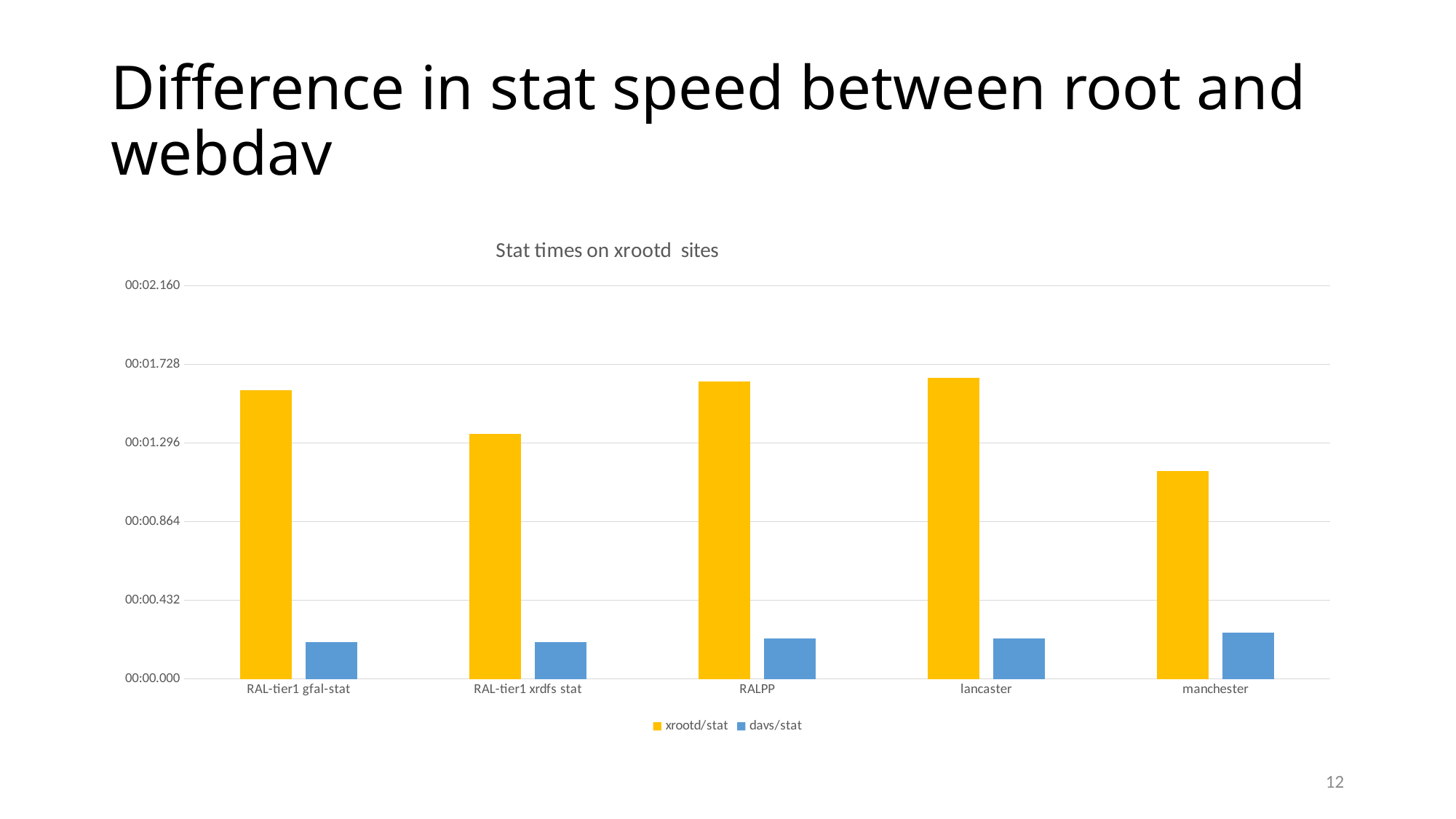
What type of chart is shown on the slide? bar chart How many sites (categories) are shown on the x axis? 5 For RALPP, which is larger: xrootd/stat or davs/stat? xrootd/stat Is the xrootd/stat value for RALPP greater or less than 00:01.728? less Which site has the lowest xrootd/stat value? manchester Is the xrootd/stat value for manchester greater or less than 00:01.296? less How many series does the legend list? 2 Which has the larger xrootd/stat value: RAL-tier1 gfal-stat or RAL-tier1 xrdfs stat? RAL-tier1 gfal-stat Is the davs/stat value for lancaster greater or less than 00:00.432? less Which series is shown in yellow? xrootd/stat What is the title of the chart? Stat times on xrootd sites